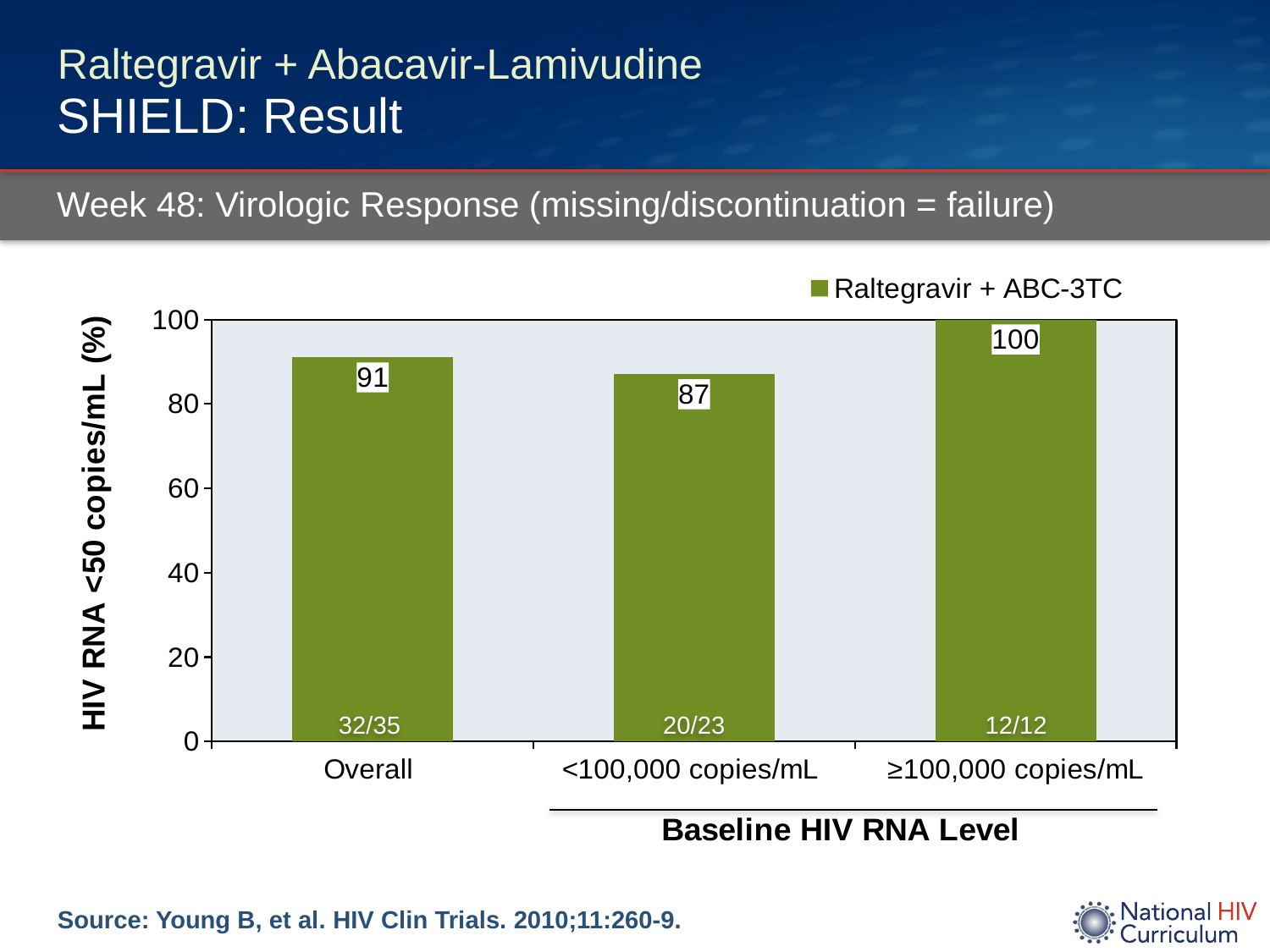
How many series does the legend list? 1 What is the value for the <100,000 copies/mL category? 87 What is the difference between the values for Overall and <100,000 copies/mL? 4 Which is larger, the value for Overall or the value for <100,000 copies/mL? Overall Which category has the lowest value? <100,000 copies/mL What is the value for the Overall category? 91 Which category has the highest value? ≥100,000 copies/mL What kind of chart is shown on the slide? Bar chart How many categories are shown on the x axis? 3 What is the value for the ≥100,000 copies/mL category? 100 What is the difference between the values for ≥100,000 copies/mL and <100,000 copies/mL? 13 What is the fraction shown at the bottom of the Overall bar? 32/35